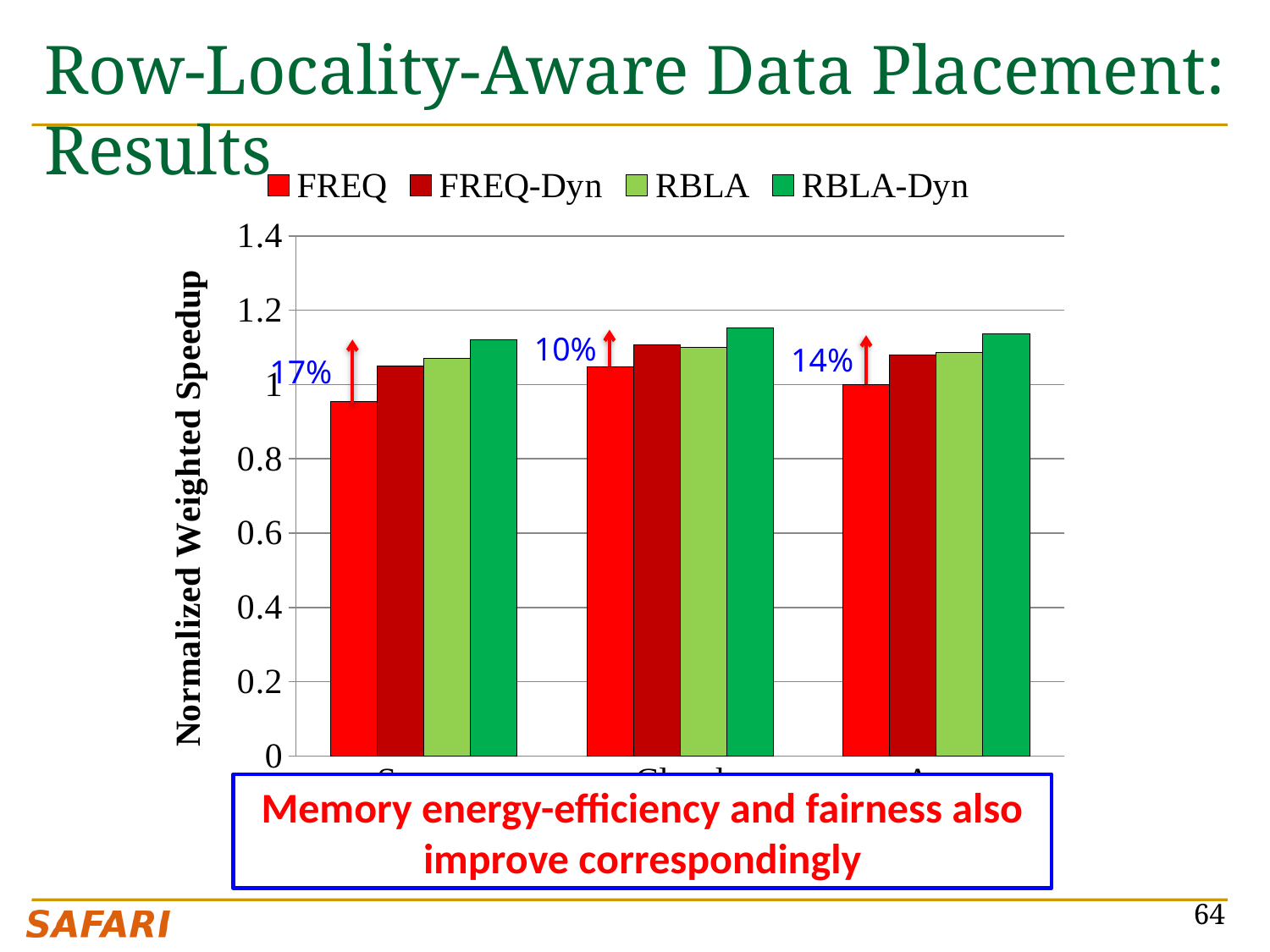
Is the tallest bar on the chart greater or less than 1.2? less What kind of chart is shown on the slide? bar chart Are the RBLA-Dyn bars greater or less than 1 on the y axis? greater How many series does the legend list? 4 What is the title of the y axis? Normalized Weighted Speedup In each group, which is larger: the RBLA-Dyn bar or the FREQ bar? RBLA-Dyn How many groups of bars (categories) are plotted along the x axis? 3 Which series has the tallest bar in every group? RBLA-Dyn What three percentage improvements are annotated above the bar groups, from left to right? 17%, 10%, 14% Which series has the shortest bar in every group? FREQ Is the leftmost FREQ bar greater or less than 1? less